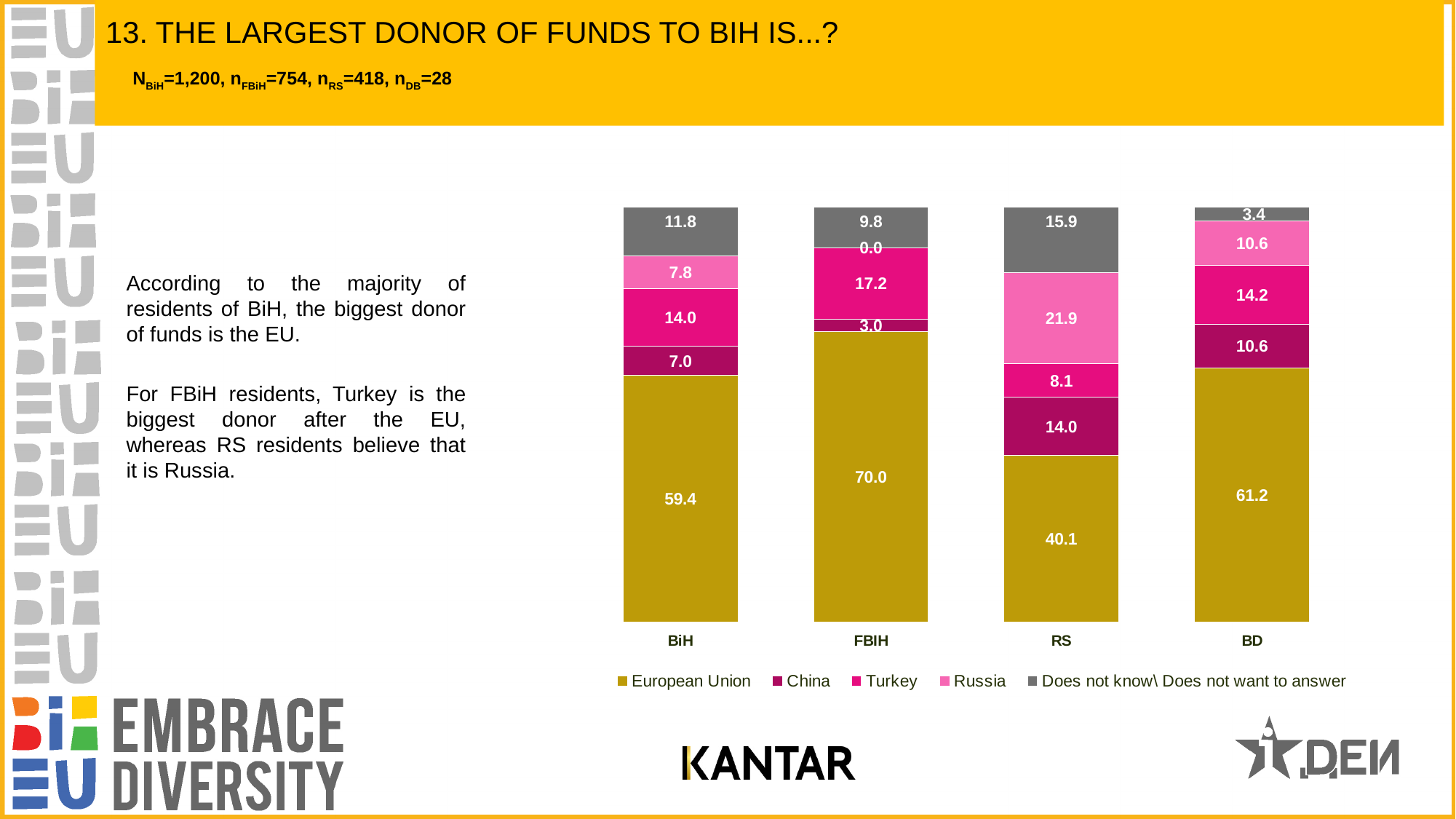
Which category has the highest European Union value? FBIH What is the 'Does not know\ Does not want to answer' value for BD? 3.4 What colour represents the European Union series in the chart? Gold What is the Russia value for RS? 21.9 What is the European Union value for FBIH? 70.0 Which category has the lowest European Union value? RS What kind of chart is shown on the slide? Stacked bar chart What is the total of the stacked bar for BD? 100.0 How many series does the legend list? 5 Which is larger, the Turkey value for BiH or the Turkey value for FBIH? FBIH What is the difference between the European Union values for FBIH and RS? 29.9 How many categories are shown on the x axis? 4